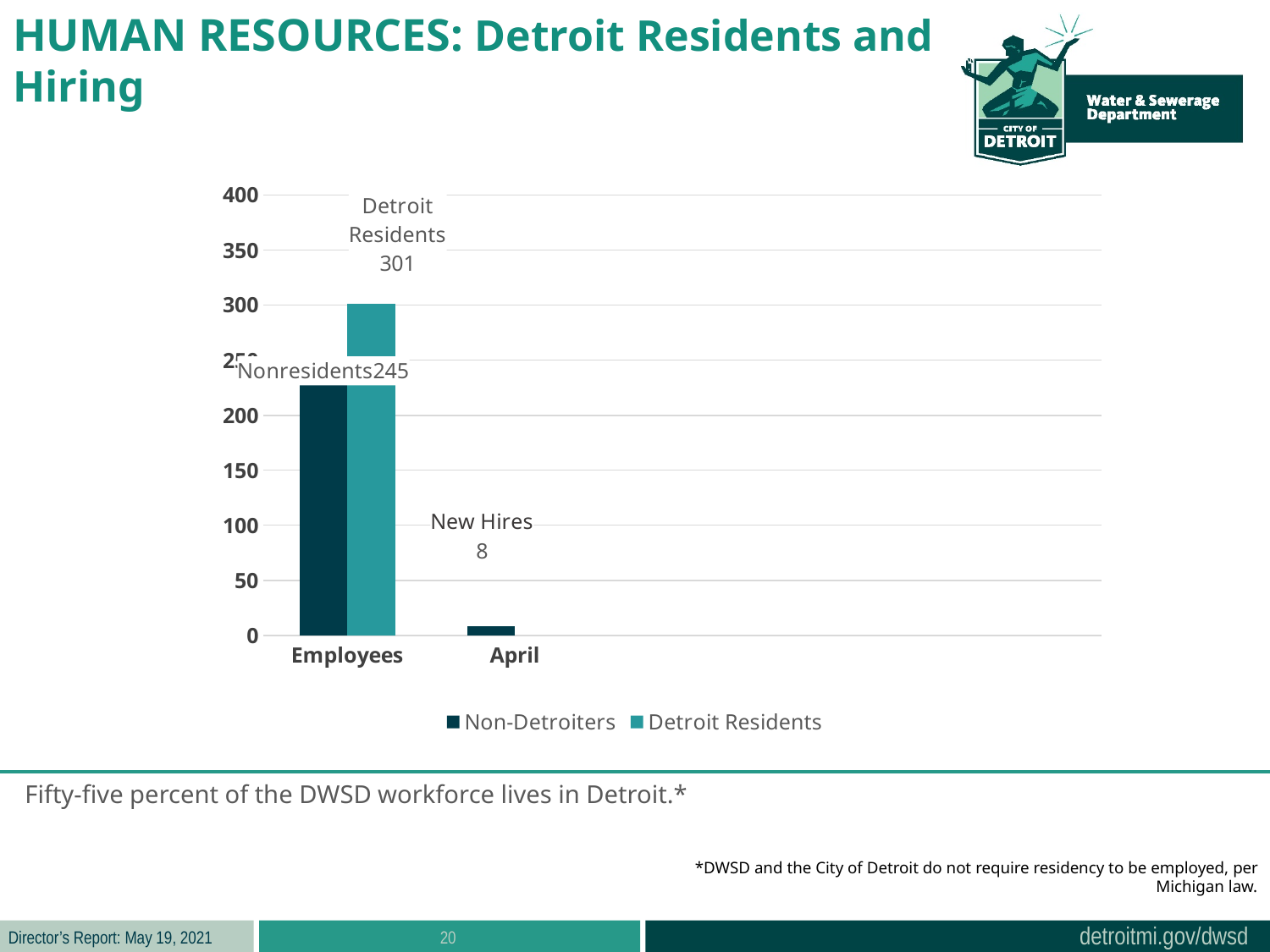
What is the total of the Employees values for Non-Detroiters (245) and Detroit Residents (301)? 546 How many series does the legend list? 2 What is the value labelled New Hires in the April category? 8 Is the New Hires value for April greater or less than 50? less What is the difference between the Detroit Residents value (301) and the Nonresidents value (245) in the Employees category? 56 How many categories are shown on the x axis? 2 What is the value for Nonresidents in the Employees category? 245 Which series has the higher value in the Employees category, Non-Detroiters or Detroit Residents? Detroit Residents What kind of chart is shown on the slide? bar chart Is the Detroit Residents value for Employees greater or less than 300? greater What are the two series named in the legend? Non-Detroiters and Detroit Residents What is the value for Detroit Residents in the Employees category? 301